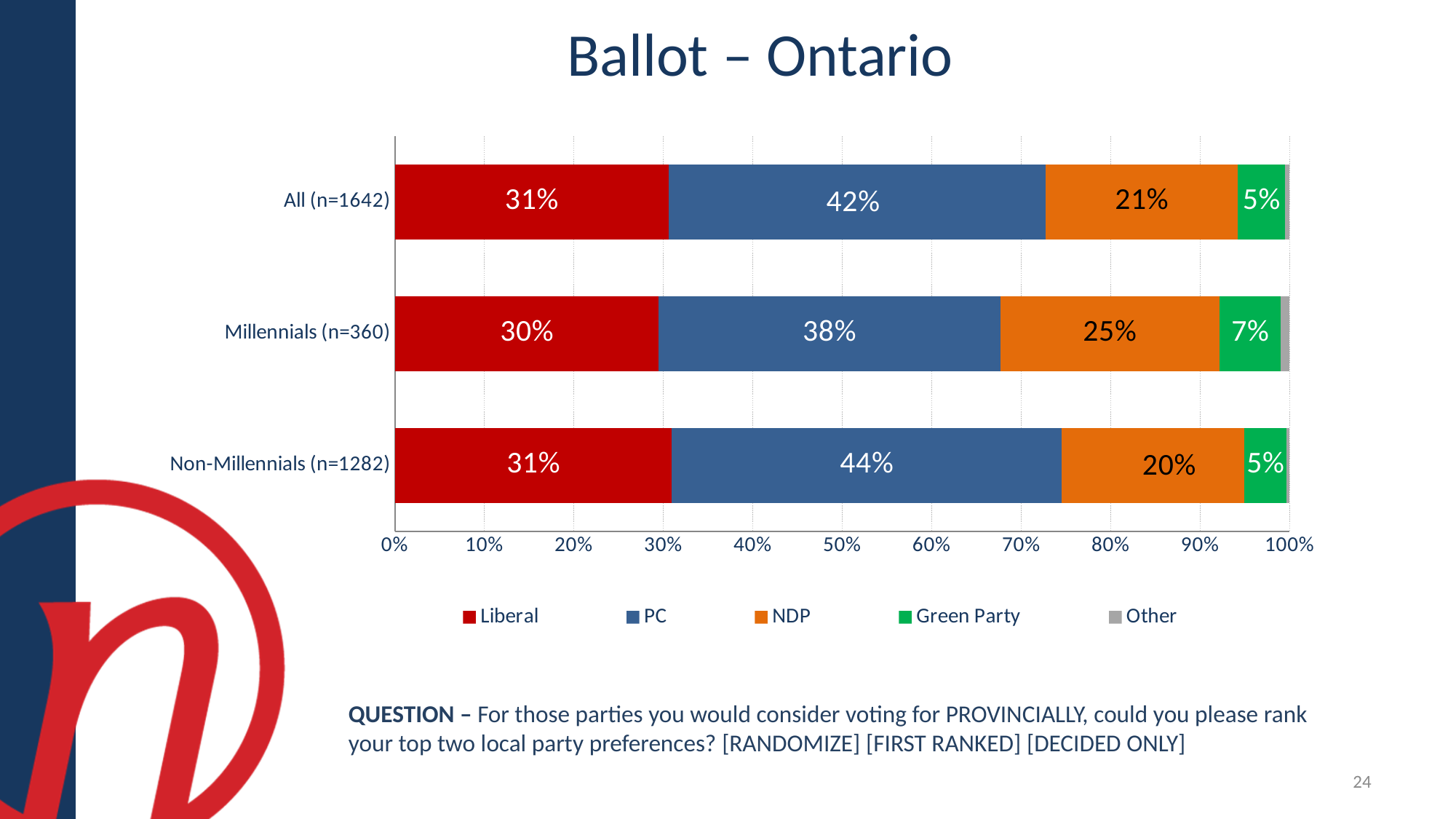
How many groups are shown on the y axis of the chart? 3 Which is larger for All (n=1642): the Liberal value or the NDP value? Liberal What is the Liberal value for All (n=1642)? 31% Which group has the highest PC value? Non-Millennials (n=1282) What is the PC value for Millennials (n=360)? 38% What is the title of the slide? Ballot – Ontario What is the difference between the PC value for Non-Millennials (n=1282) and the PC value for Millennials (n=360)? 6% What is the NDP value for Non-Millennials (n=1282)? 20% What is the Green Party value for Millennials (n=360)? 7% Which group has the lowest NDP value? Non-Millennials (n=1282) What kind of chart is shown on the slide? Stacked bar chart How many series does the legend list? 5